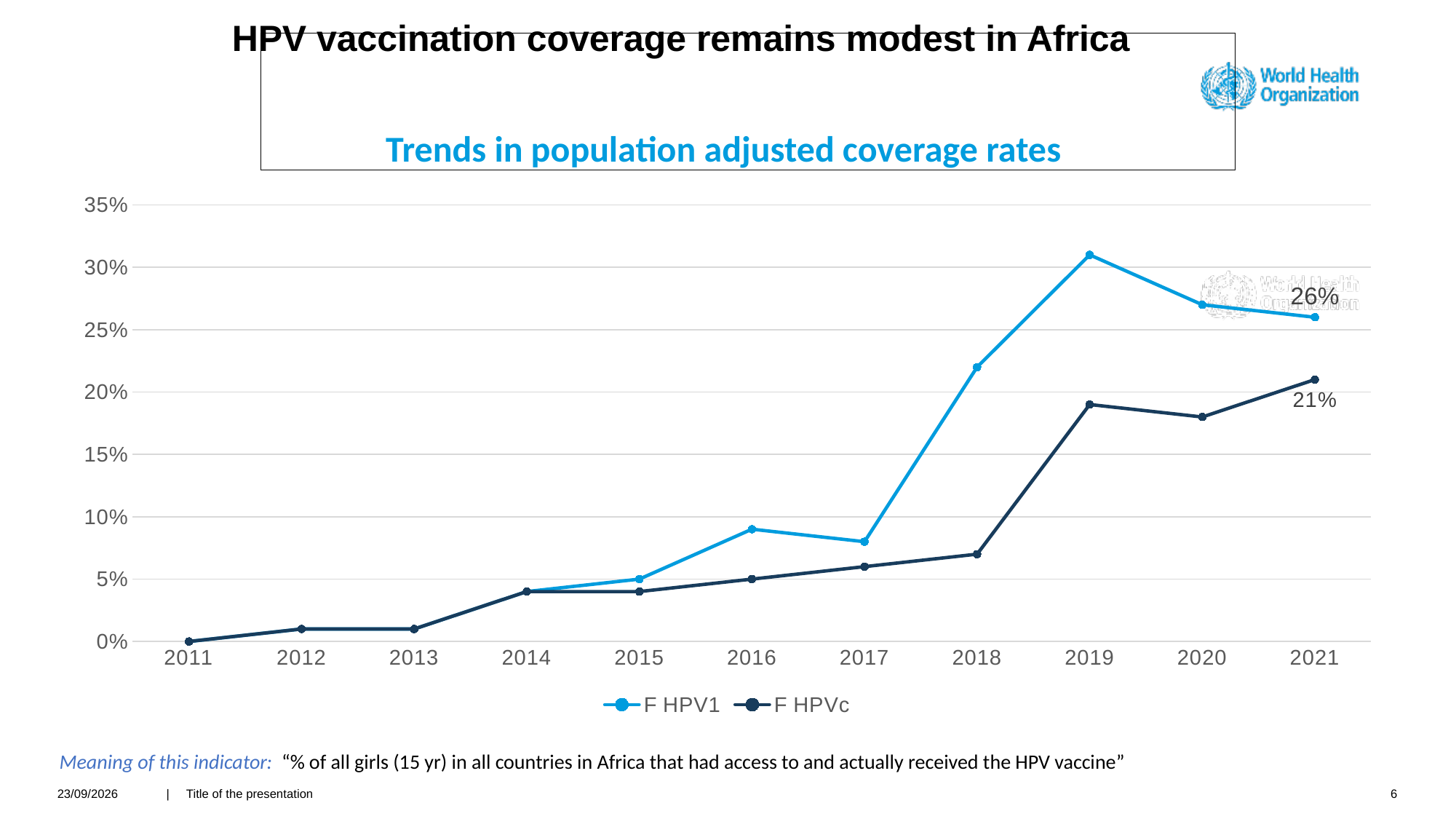
How many years are shown on the x axis? 11 Does the F HPVc series generally rise or fall from 2011 to 2021? Rise Is the value for F HPV1 in 2018 greater or less than 20%? greater What is the difference between F HPV1 and F HPVc in 2021? 5 percentage points What is the subtitle of the chart? Trends in population adjusted coverage rates In which year does F HPV1 reach its highest value? 2019 How many series does the legend list? 2 What type of chart is shown on the slide? Line chart Which series has the larger value in 2021, F HPV1 or F HPVc? F HPV1 Is the value for F HPVc in 2019 greater or less than 20%? less What is the value for F HPV1 in 2021? 26% What is the value for F HPVc in 2021? 21%